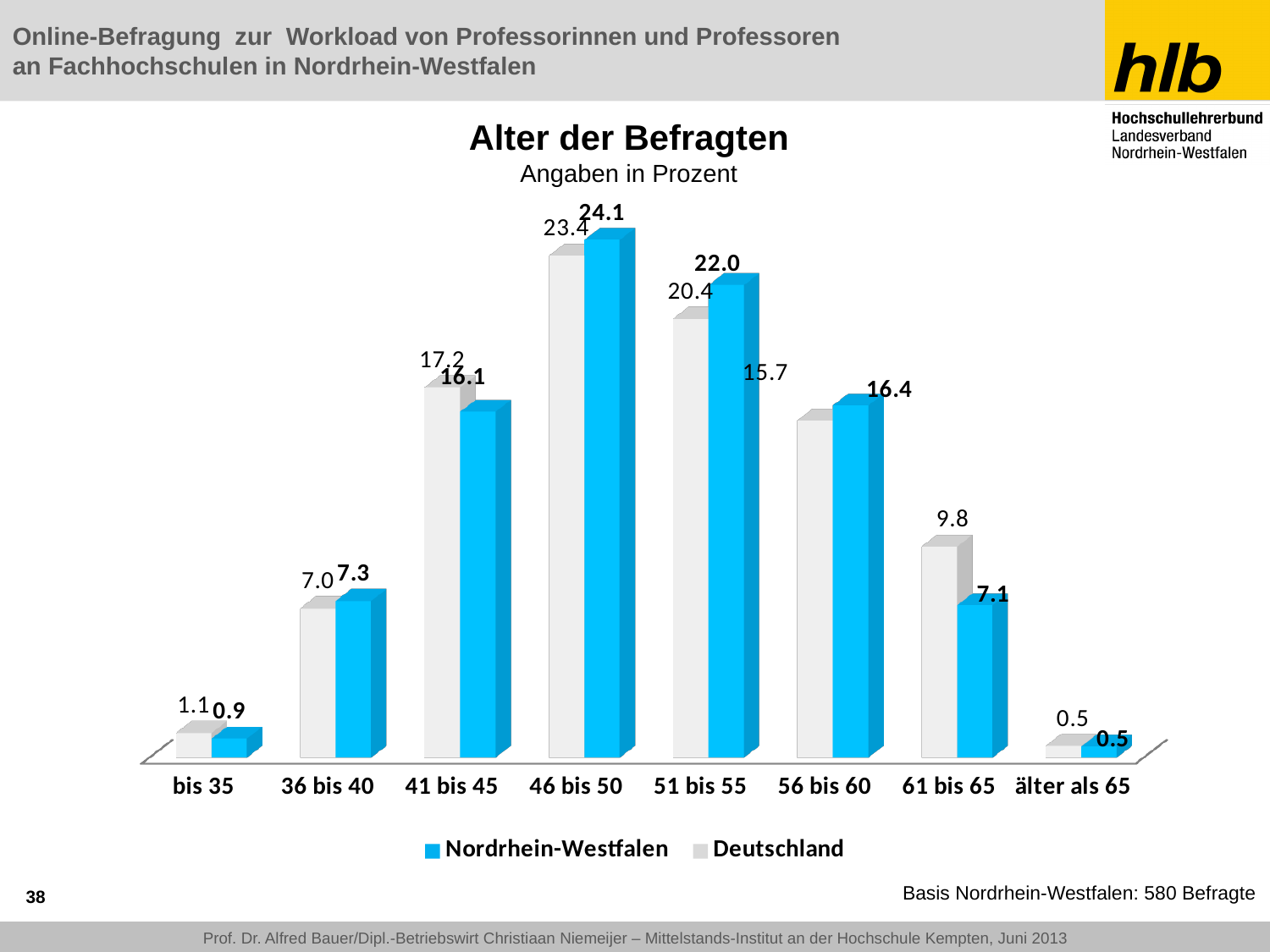
In the 51 bis 55 age group, which series has the larger value, Nordrhein-Westfalen or Deutschland? Nordrhein-Westfalen What is the difference between the Deutschland and Nordrhein-Westfalen values in the 61 bis 65 age group? 2.7 What is the title of the chart? Alter der Befragten What is the value for Nordrhein-Westfalen in the 46 bis 50 age group? 24.1 What kind of chart is shown on the slide? Bar chart Which age group has the lowest value for Deutschland? älter als 65 What is the value for Deutschland in the 41 bis 45 age group? 17.2 How many series does the legend list? 2 What is the value for Nordrhein-Westfalen in the 51 bis 55 age group? 22.0 Which age group has the highest value for Nordrhein-Westfalen? 46 bis 50 What is the value for Deutschland in the 61 bis 65 age group? 9.8 How many age groups are shown on the x axis? 8